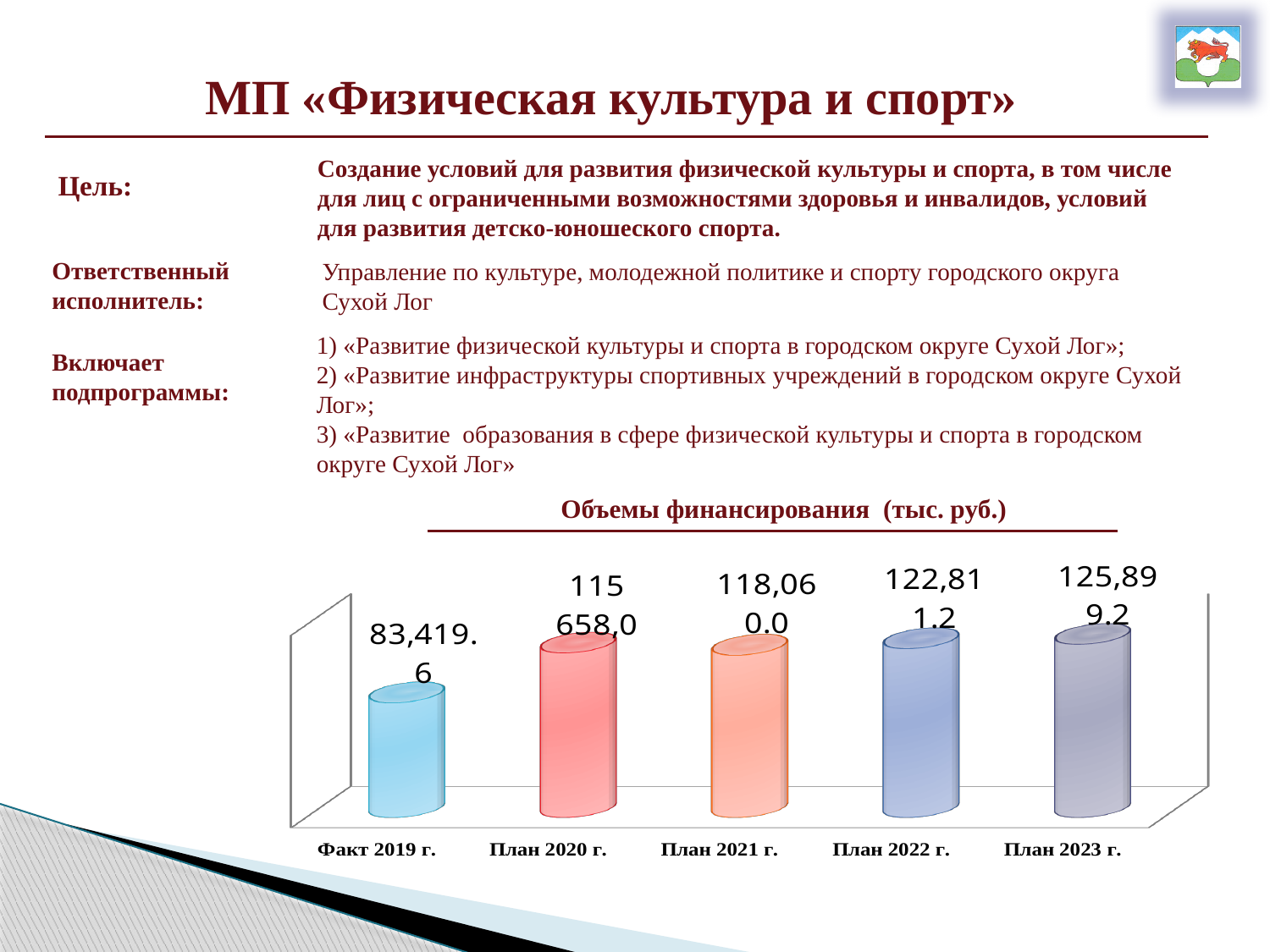
What is the value for План 2020 г. in the chart «Объемы финансирования (тыс. руб.)»? 115 658,0 What is the value for План 2021 г. in the chart «Объемы финансирования (тыс. руб.)»? 118,060.0 How many categories are shown in the chart «Объемы финансирования (тыс. руб.)»? 5 Which category has the lowest value in the chart «Объемы финансирования (тыс. руб.)»? Факт 2019 г. In the chart «Объемы финансирования (тыс. руб.)», what is the difference between the values for План 2023 г. and План 2022 г.? 3,088.0 What is the value for План 2023 г. in the chart «Объемы финансирования (тыс. руб.)»? 125,899.2 Which category has the highest value in the chart «Объемы финансирования (тыс. руб.)»? План 2023 г. Do the values in the chart «Объемы финансирования (тыс. руб.)» rise or fall from Факт 2019 г. to План 2023 г.? Rise In the chart «Объемы финансирования (тыс. руб.)», which is larger: the value for План 2020 г. or the value for Факт 2019 г.? План 2020 г. What is the value for Факт 2019 г. in the chart «Объемы финансирования (тыс. руб.)»? 83,419.6 What is the value for План 2022 г. in the chart «Объемы финансирования (тыс. руб.)»? 122,811.2 What kind of chart is «Объемы финансирования (тыс. руб.)»? Bar chart